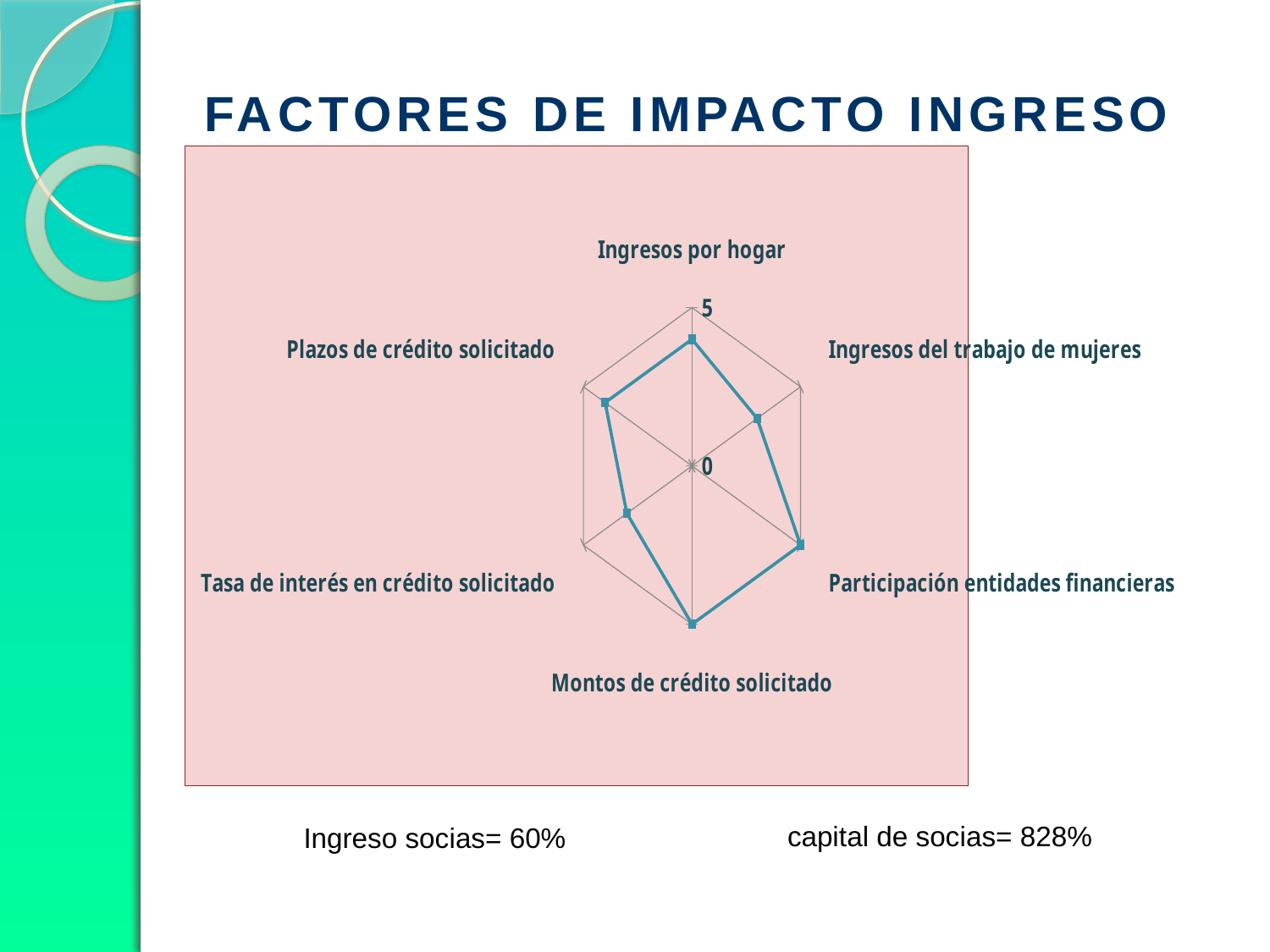
How many data series are plotted on the radar chart? 1 How many categories (axes) does the radar chart have? 6 Which has the larger value, Participación entidades financieras or Tasa de interés en crédito solicitado? Participación entidades financieras What is the title of the slide containing the radar chart? FACTORES DE IMPACTO INGRESO Is the value for Ingresos del trabajo de mujeres greater or less than 5? less Is the value for Ingresos por hogar greater or less than 5? less Which has the larger value, Ingresos por hogar or Tasa de interés en crédito solicitado? Ingresos por hogar What kind of chart is shown on the slide? radar chart Which has the larger value, Montos de crédito solicitado or Ingresos del trabajo de mujeres? Montos de crédito solicitado What is the maximum value shown on the radar chart's axis scale? 5 Is the value for Tasa de interés en crédito solicitado greater or less than 5? less